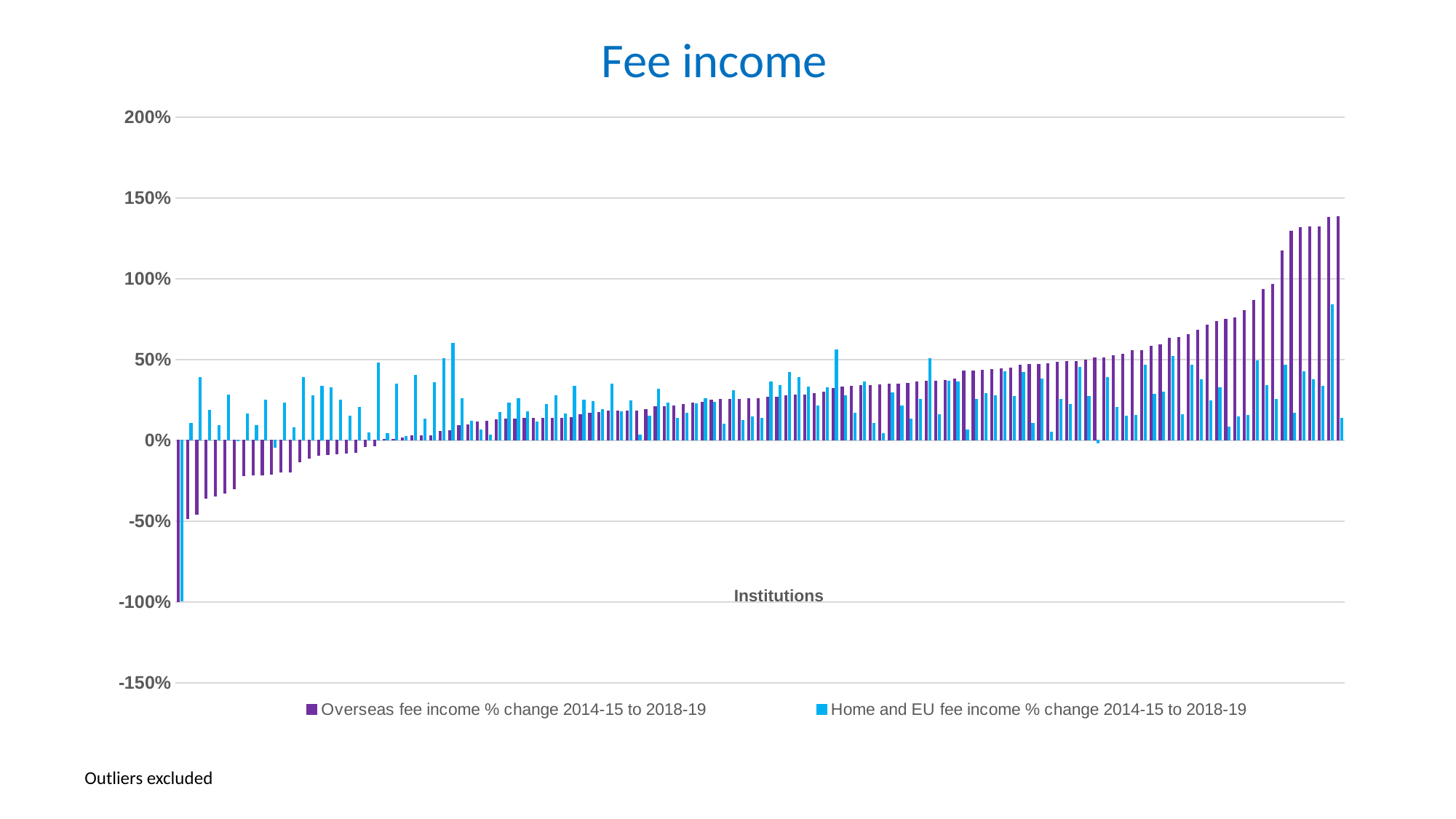
What kind of chart is shown on the slide? Bar chart Which series contains the tallest bar on the chart, Overseas fee income % change or Home and EU fee income % change? Overseas fee income % change 2014-15 to 2018-19 Is the tallest Overseas fee income % change bar greater or less than 100%? greater Is the tallest Home and EU fee income % change bar greater or less than 100%? less Is the rightmost Overseas fee income % change bar greater or less than 150%? less How many series does the legend list? 2 What label is shown on the x axis of the chart? Institutions Do the Overseas fee income % change bars rise or fall from left to right along the x axis? Rise What is the title of the chart? Fee income